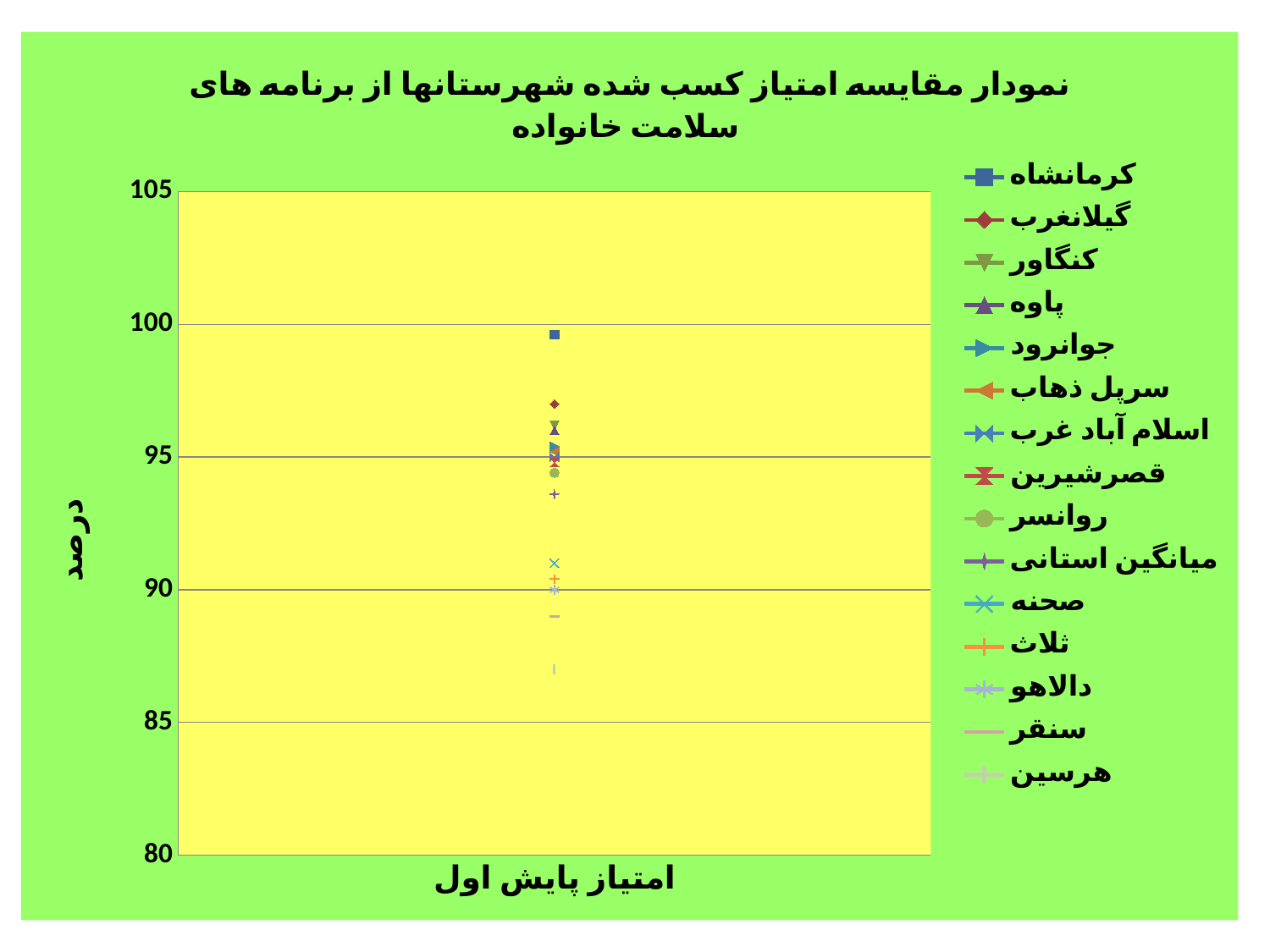
Which is larger, the value for صحنه or the value for هرسین? صحنه How many categories are shown on the x axis? 1 Is the value for هرسین greater or less than 90? less What is the label of the x axis? امتیاز پایش اول Which is larger, the value for کرمانشاه or the value for گیلانغرب? کرمانشاه Which series has the lowest value? هرسین How many series does the legend list? 15 Is the value for میانگین استانی greater or less than 95? less Which series has the highest value? کرمانشاه Is the value for صحنه greater or less than 90? greater